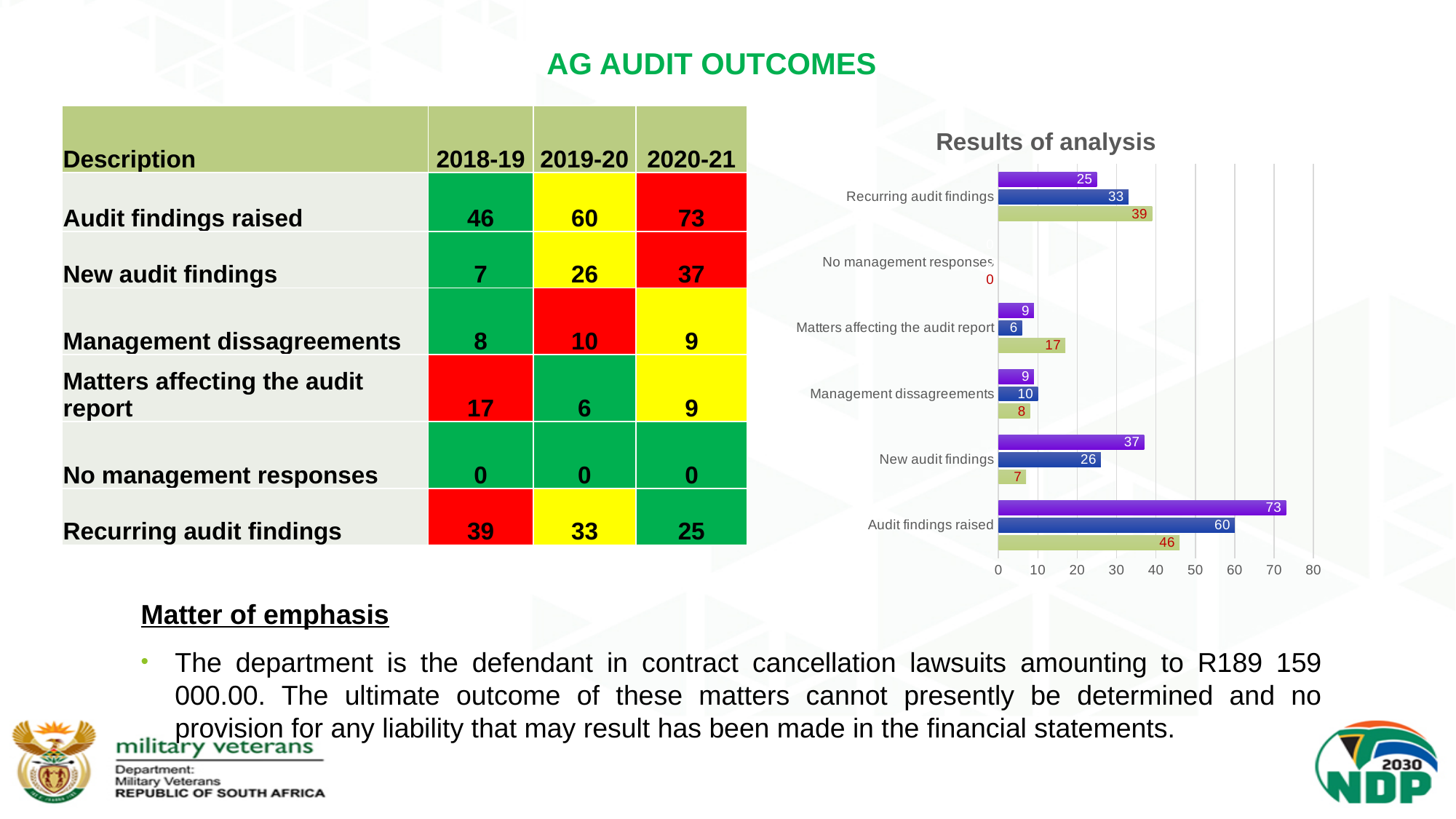
In the "Results of analysis" chart, what is the value of the blue bar for New audit findings? 26 What type of chart is shown under the title "Results of analysis"? bar chart How many categories are shown on the vertical axis of the "Results of analysis" chart? 6 In the "Results of analysis" chart, what is the value of the light green bar for Matters affecting the audit report? 17 In the "Results of analysis" chart, what is the value of the light green bar for Audit findings raised? 46 In the "Results of analysis" chart, which category has the lowest value across all bars? No management responses In the "Results of analysis" chart, which is larger for Management dissagreements: the blue bar or the light green bar? the blue bar In the "Results of analysis" chart, what is the difference between the purple bar and the light green bar for Recurring audit findings? 14 In the "Results of analysis" chart, what is the value of the purple bar for Audit findings raised? 73 In the "Results of analysis" chart, is the blue bar for Audit findings raised greater or less than 50? greater In the "Results of analysis" chart, which category has the highest purple bar? Audit findings raised What is the title of the chart on the right of the slide? Results of analysis